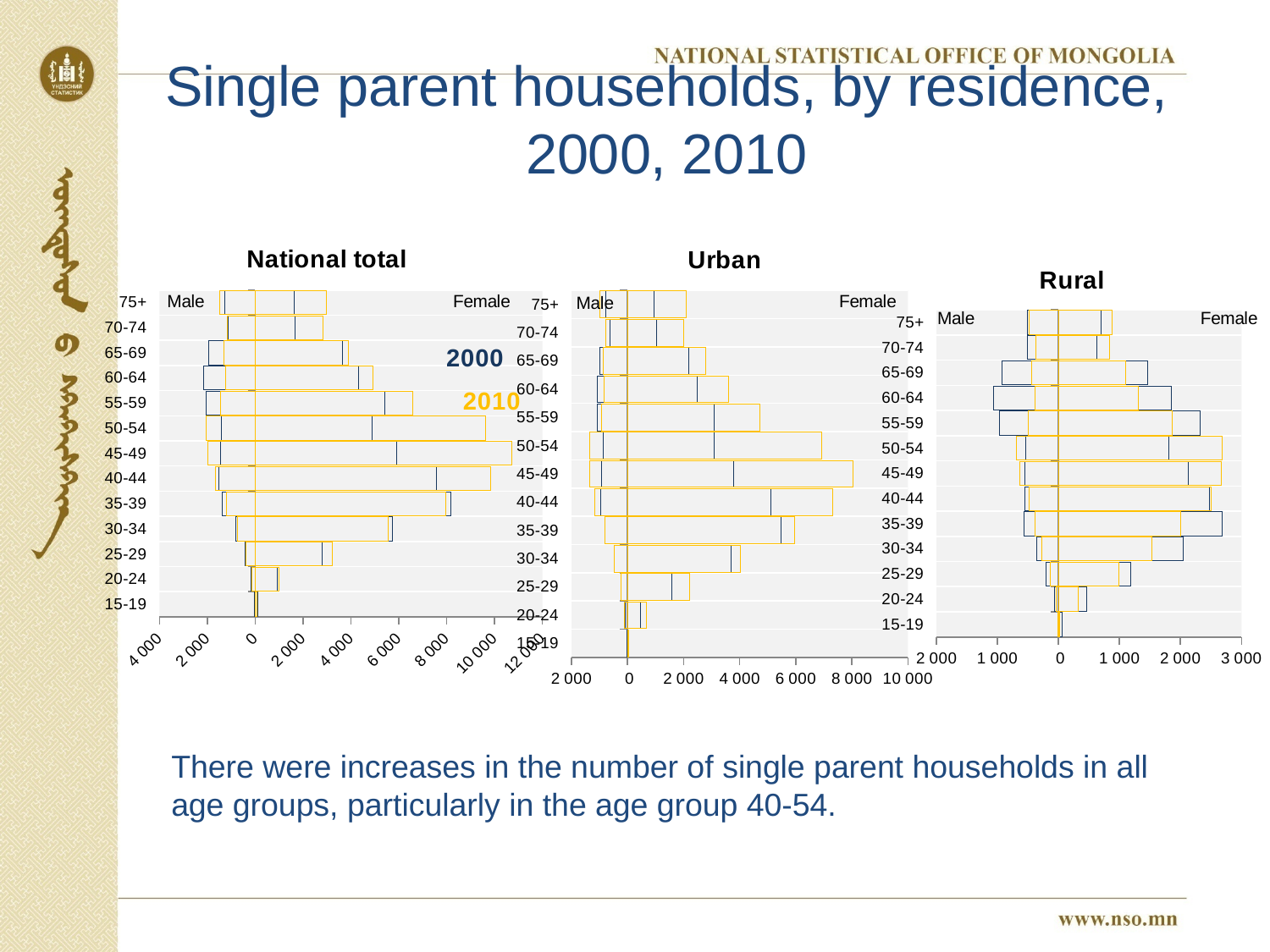
On the National total chart, is the female value for 2010 in the 45-49 age group greater or less than 10 000? greater How many age groups are shown on the Urban chart? 13 Which two years are shown in the legend of the National total chart? 2000 and 2010 On the Urban chart, which age group has the highest female value for 2010? 45-49 On the National total chart, which age group has the highest female value for 2010? 45-49 On the Rural chart, is the female value for 2010 in the 25-29 age group greater or less than 2 000? less What are the titles of the three charts on the slide? National total, Urban, Rural How many series does the legend on the National total chart list? 2 On the National total chart, which age group has the lowest female value for 2010? 15-19 On the Urban chart, is the female value for 2010 in the 45-49 age group greater or less than 6 000? greater What kind of chart is the National total chart? bar chart On the National total chart, which is larger for females in 2010: the 45-49 age group or the 25-29 age group? 45-49